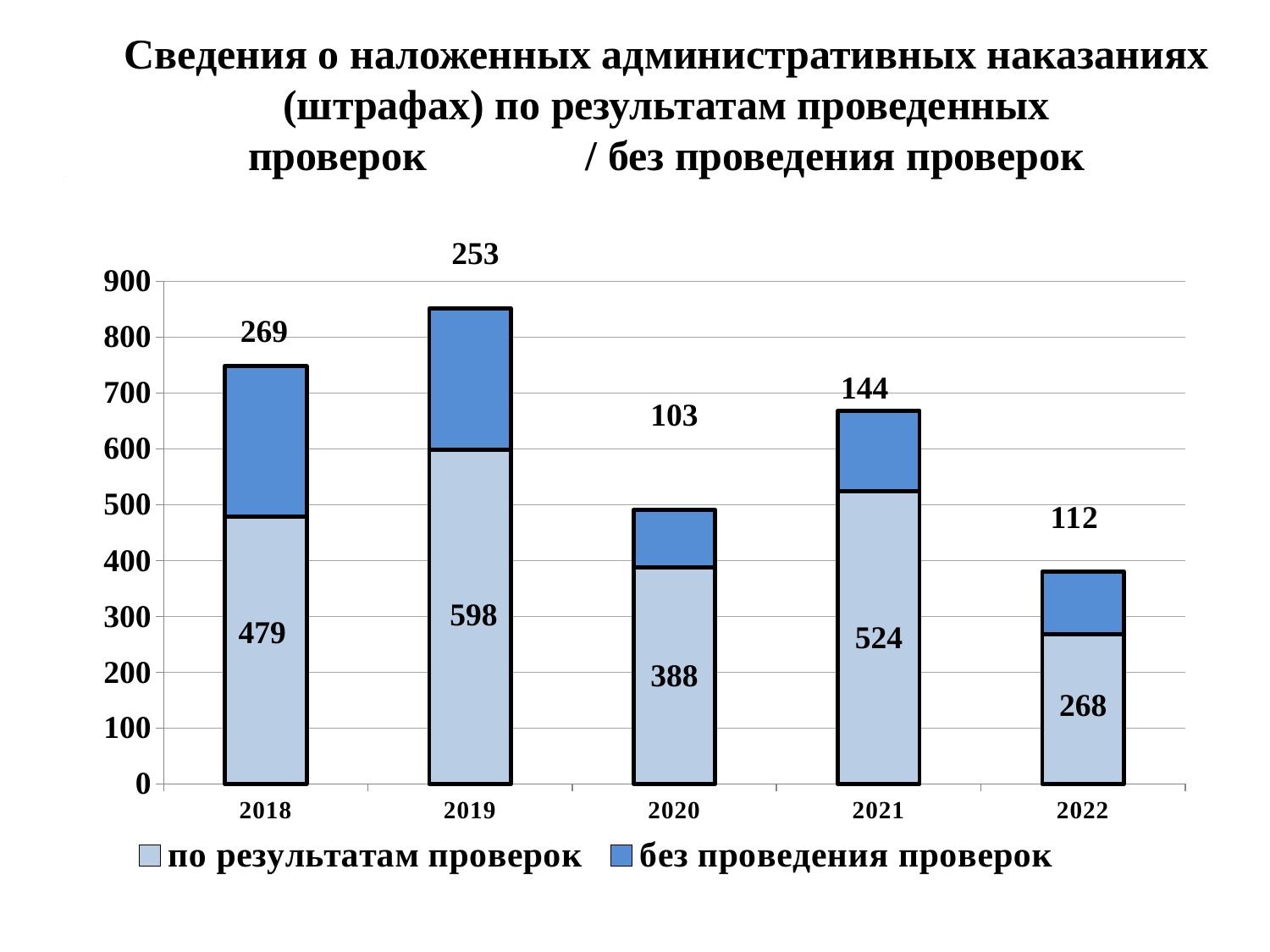
Which year has the highest value for 'по результатам проверок'? 2019 What is the value for 'по результатам проверок' in 2022? 268 What is the difference between the 'по результатам проверок' values for 2019 and 2020? 210 Which year has the lowest value for 'без проведения проверок'? 2020 Which is larger: 'без проведения проверок' in 2018 or in 2022? 2018 How many series does the legend list? 2 What is the total of the stacked bar for 2018? 748 What type of chart is shown on the slide? stacked bar chart Which series is shown in the darker blue colour? без проведения проверок What is the value for 'по результатам проверок' in 2019? 598 What is the value for 'без проведения проверок' in 2021? 144 How many years are shown on the x axis? 5